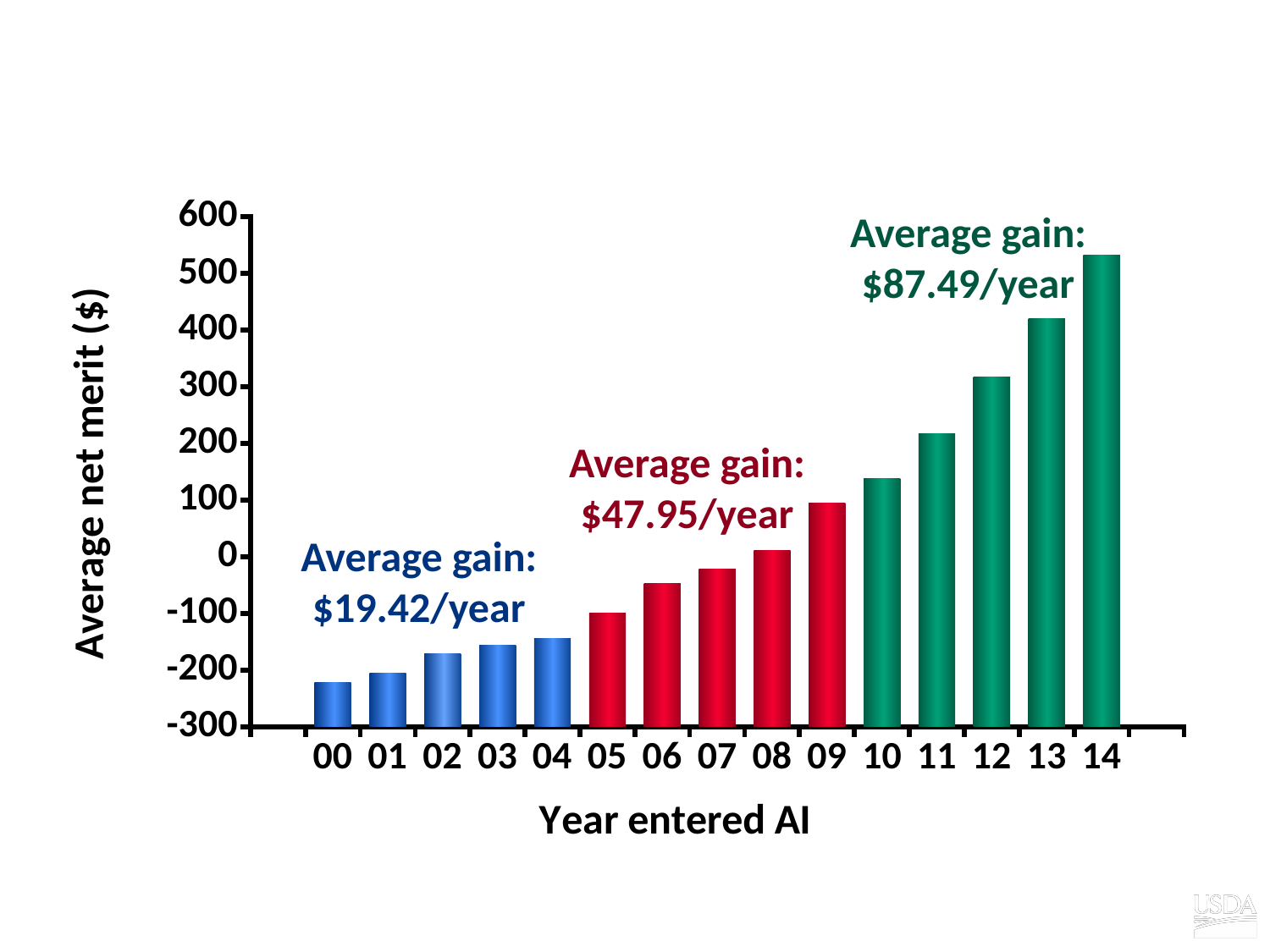
Which has a higher average net merit, year 09 or year 13? 13 What kind of chart is shown on the slide? bar chart Which year entered AI has the highest average net merit? 14 How many years (bars) are plotted on the x axis? 15 Is the average net merit for year 12 greater or less than 300? greater What is the title of the x axis? Year entered AI Is the average net merit for year 00 greater or less than -200? less Is the average net merit for year 11 greater or less than 200? greater What average gain per year is annotated for the green bars (years 10 to 14)? $87.49/year Which year entered AI has the lowest average net merit? 00 Do the average net merit values rise or fall as the year entered AI increases? rise